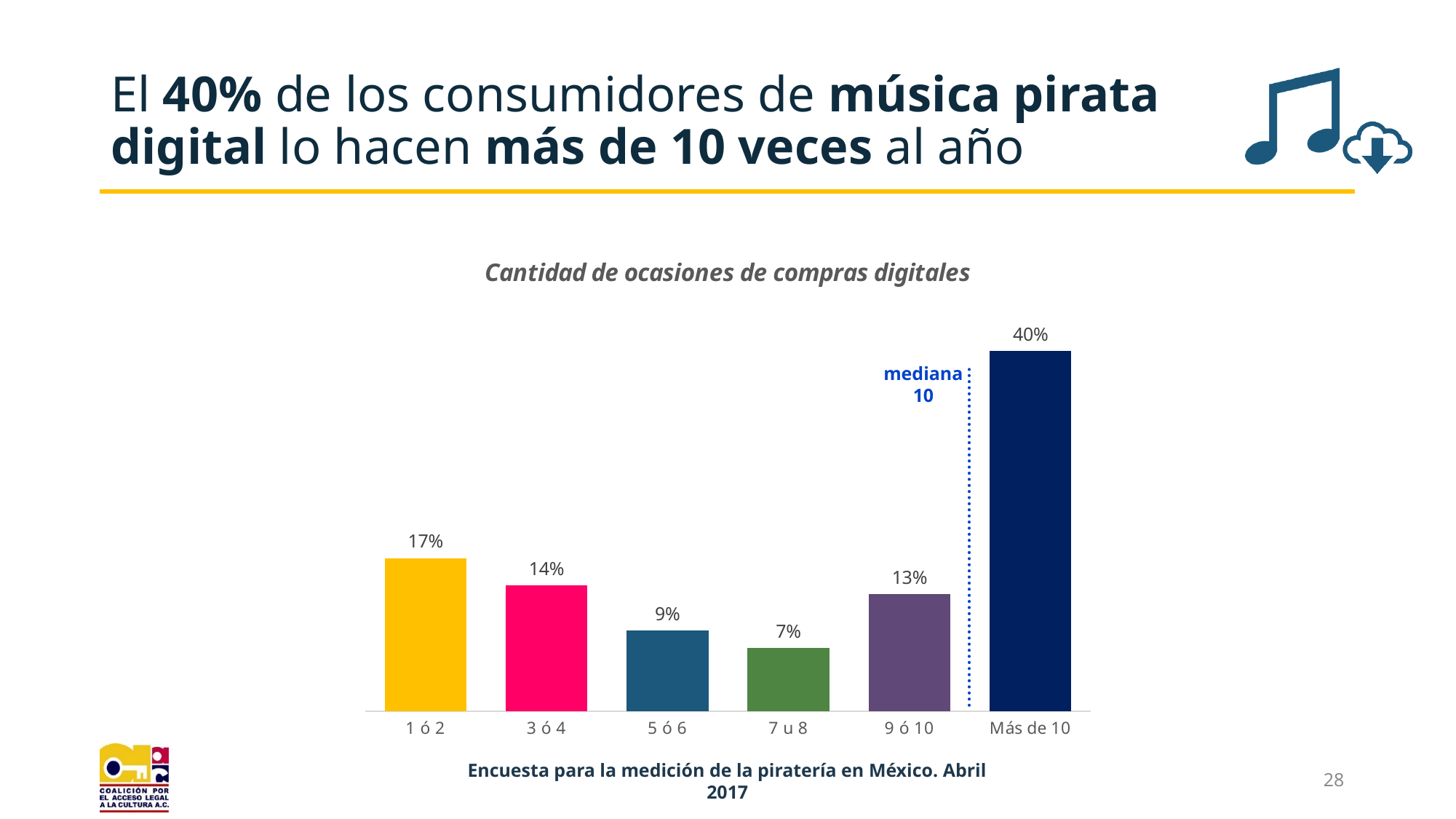
What is the value for the '3 ó 4' category? 14% Which is larger, the value for '3 ó 4' or the value for '9 ó 10'? 3 ó 4 What is the difference between the values for '9 ó 10' and '5 ó 6'? 4% What is the difference between the values for 'Más de 10' and '1 ó 2'? 23% What kind of chart is shown on the slide? Bar chart What is the title of the chart? Cantidad de ocasiones de compras digitales How many categories are shown on the x axis? 6 What is the value for the 'Más de 10' category? 40% Which category has the lowest value? 7 u 8 What is the value for the '7 u 8' category? 7% What is the value for the '1 ó 2' category? 17% Which category has the highest value? Más de 10